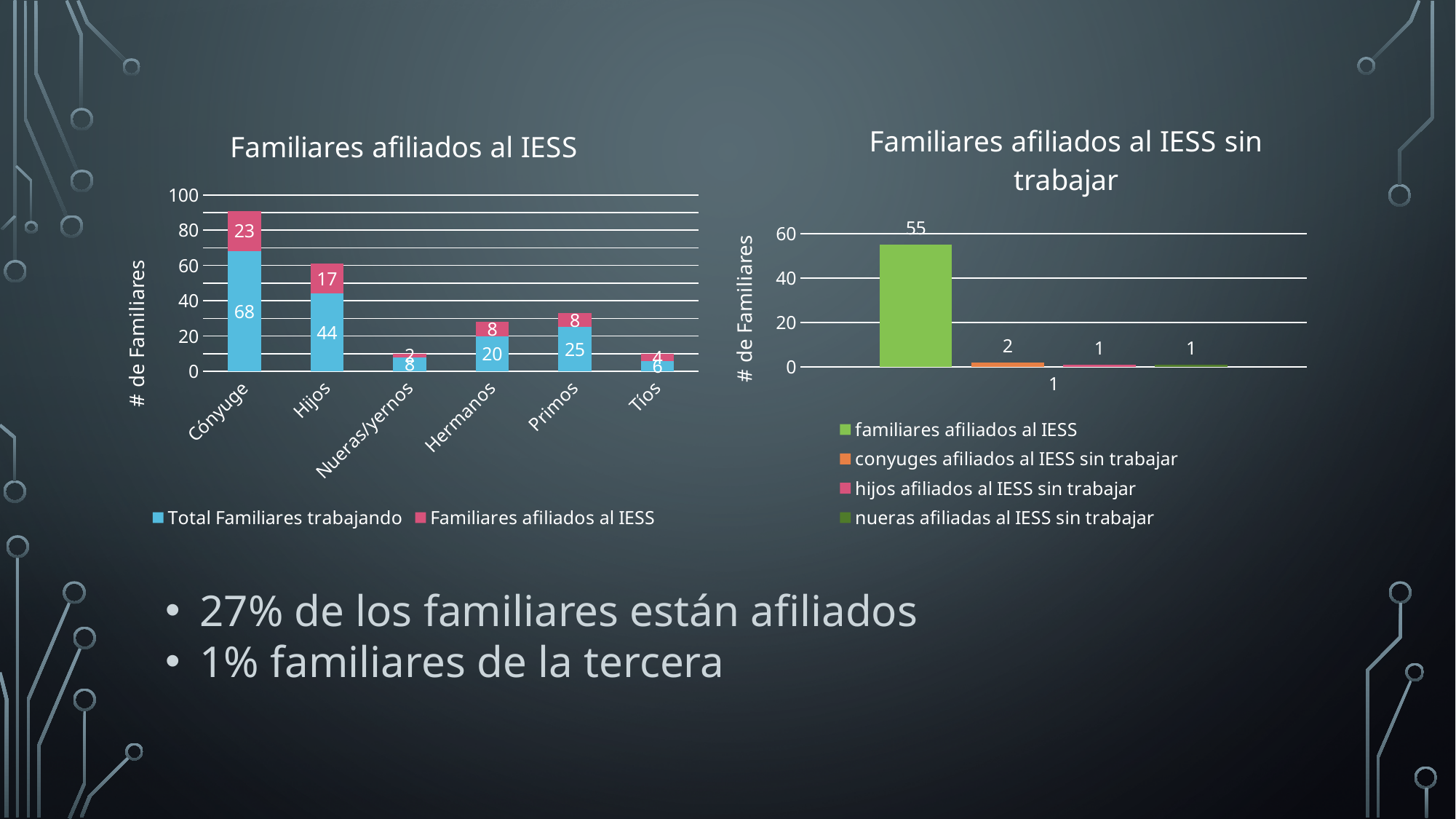
How many series does the legend of the chart 'Familiares afiliados al IESS sin trabajar' list? 4 In the chart 'Familiares afiliados al IESS', what is the value of 'Familiares afiliados al IESS' for Hijos? 17 In the chart 'Familiares afiliados al IESS', how many categories are shown on the x axis? 6 In the chart 'Familiares afiliados al IESS', is 'Total Familiares trabajando' for Primos larger than for Hermanos? Yes In the chart 'Familiares afiliados al IESS', what is the total of the stacked bar for Hermanos? 28 In the chart 'Familiares afiliados al IESS sin trabajar', what is the value for 'familiares afiliados al IESS'? 55 What type of chart is 'Familiares afiliados al IESS' on the left? Stacked bar chart In the chart 'Familiares afiliados al IESS', which category has the highest 'Total Familiares trabajando' value? Cónyuge In the chart 'Familiares afiliados al IESS', which category has the lowest 'Familiares afiliados al IESS' value? Nueras/yernos In the chart 'Familiares afiliados al IESS', what is the value of 'Total Familiares trabajando' for Cónyuge? 68 In the chart 'Familiares afiliados al IESS', what is the difference between 'Total Familiares trabajando' for Cónyuge and for Hijos? 24 In the chart 'Familiares afiliados al IESS sin trabajar', what is the value for 'conyuges afiliados al IESS sin trabajar'? 2